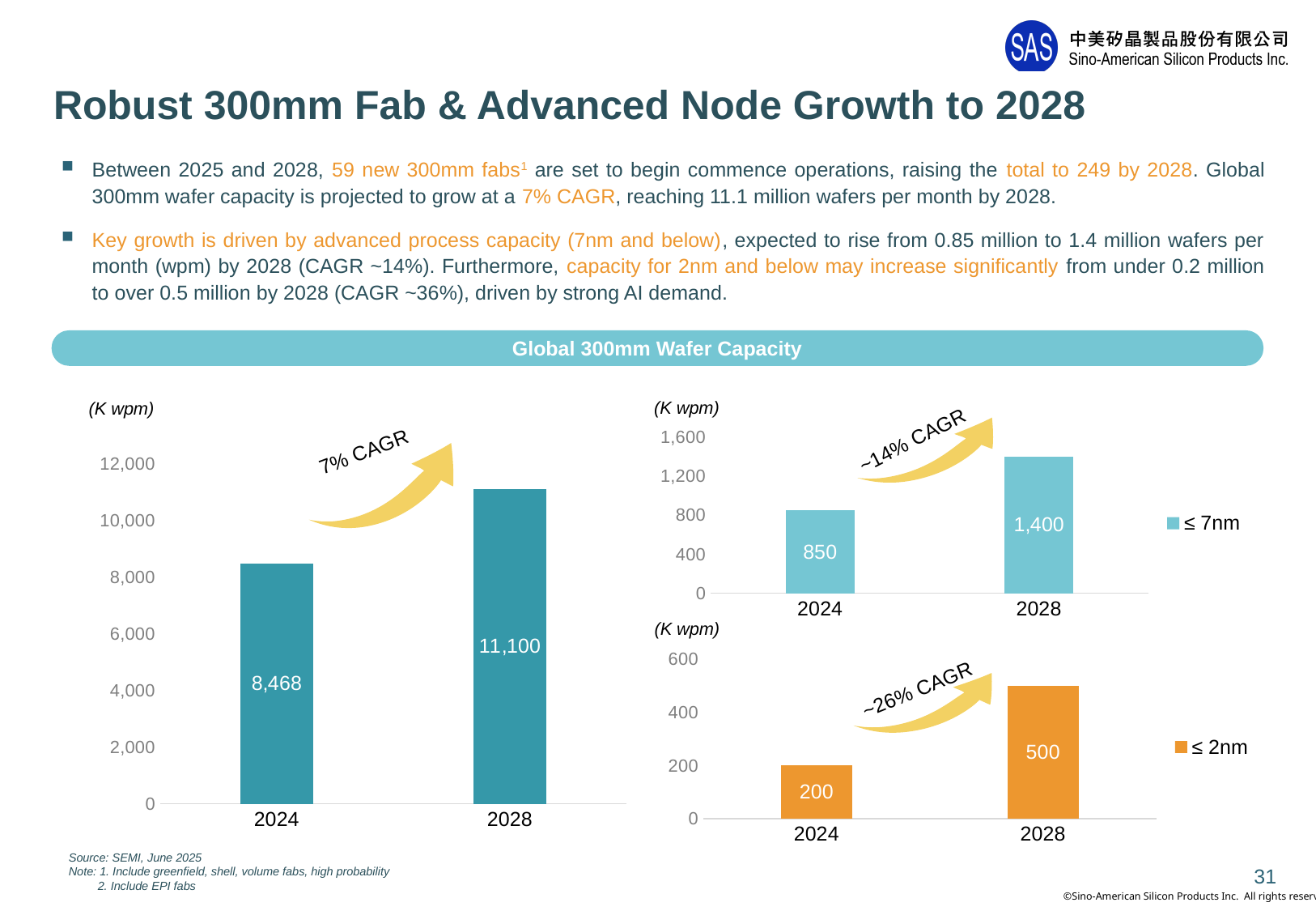
In the bottom-right chart (≤ 2nm), what is the difference between the 2028 and 2024 values? 300 In the left chart (Global 300mm Wafer Capacity, total), what is the value for 2028? 11,100 In the top-right chart (≤ 7nm), what is the difference between the 2028 and 2024 values? 550 In the left chart (Global 300mm Wafer Capacity, total), what is the value for 2024? 8,468 What kind of chart is the left chart (Global 300mm Wafer Capacity, total)? bar chart In the bottom-right chart (≤ 2nm), what is the value for 2028? 500 What CAGR is annotated on the top-right chart (≤ 7nm)? ~14% CAGR In the top-right chart (≤ 7nm), what is the value for 2028? 1,400 In the left chart (Global 300mm Wafer Capacity, total), is the value for 2024 greater or less than 10,000? less In the bottom-right chart (≤ 2nm), which year has the lower value? 2024 In the top-right chart (≤ 7nm), what is the value for 2024? 850 In the left chart (Global 300mm Wafer Capacity, total), what is the difference between the 2028 and 2024 values? 2,632